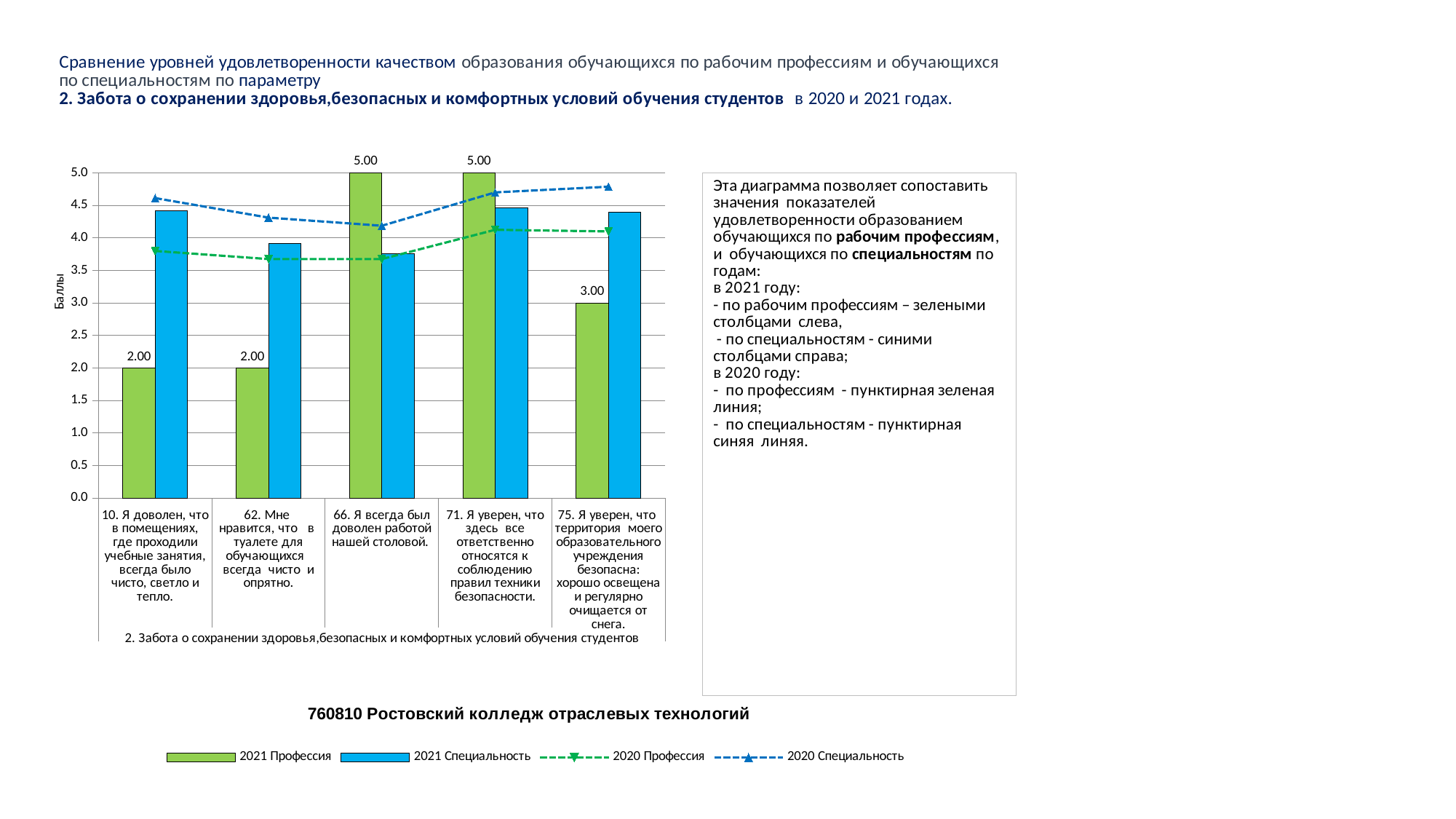
What is the title of the vertical axis of the chart? Баллы How many series does the legend list? 4 Is the 2021 Специальность value for category 66 (Я всегда был доволен работой нашей столовой) greater or less than 4.0? less For category 66, which is larger: the 2021 Профессия bar or the 2021 Специальность bar? 2021 Профессия What is the value of the 2021 Профессия bar for category 66 (Я всегда был доволен работой нашей столовой)? 5.00 What kind of chart is shown on the slide? Bar and line chart What is the difference between the 2021 Профессия values for category 75 and category 10? 1.00 What is the value of the 2021 Профессия bar for category 75 (Я уверен, что территория моего образовательного учреждения безопасна)? 3.00 What is the value of the 2021 Профессия bar for category 10 (Я доволен, что в помещениях, где проходили учебные занятия, всегда было чисто, светло и тепло)? 2.00 What is the difference between the 2021 Профессия values for category 66 and category 75? 2.00 For category 10, which is larger: the 2021 Профессия bar or the 2021 Специальность bar? 2021 Специальность How many categories are shown on the x axis of the chart? 5